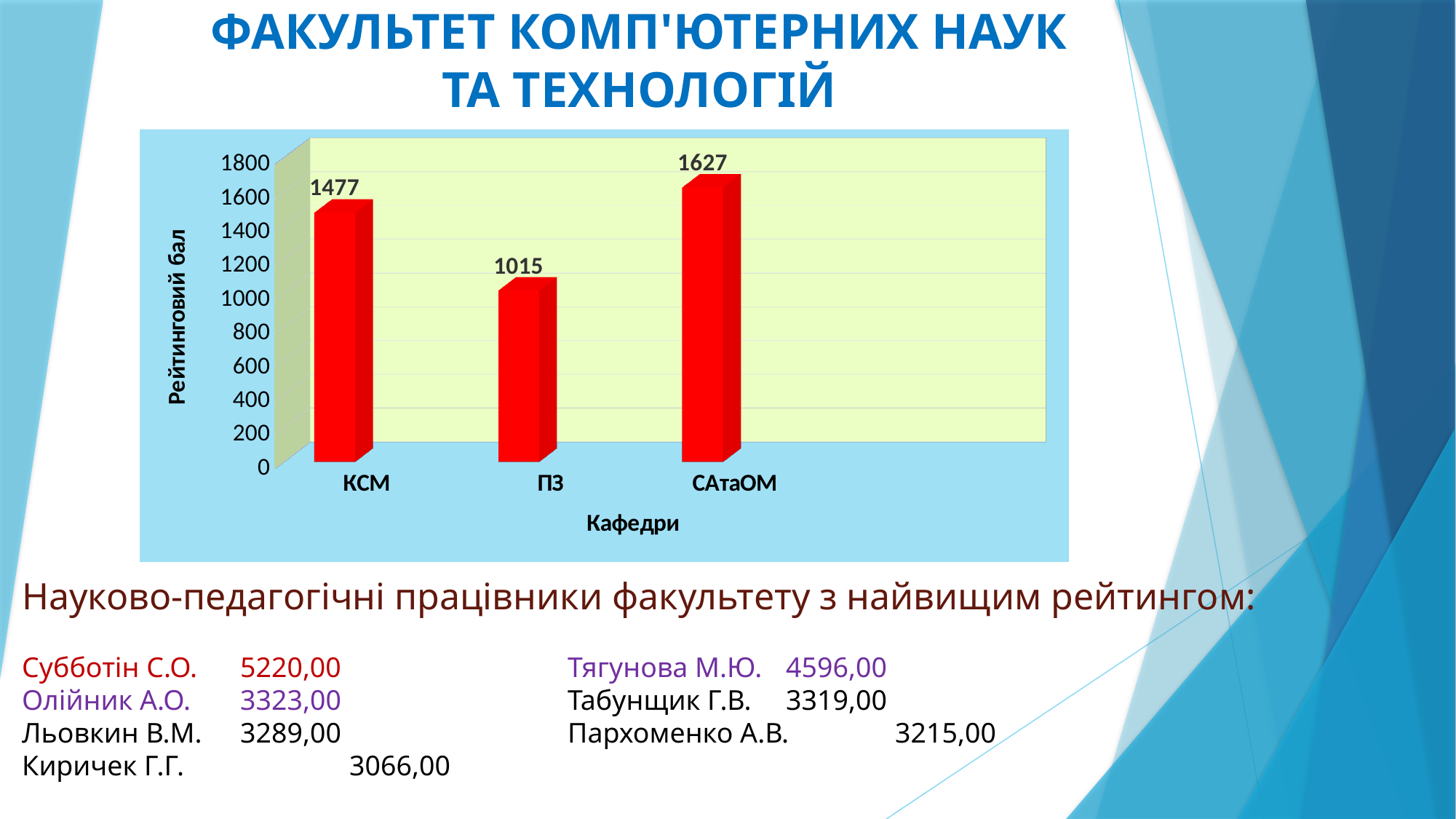
How many departments are shown on the chart? 3 Is the value for ПЗ greater or less than 1200? less What is the difference between the rating scores of САтаОМ and КСМ? 150 Which department has the lowest rating score? ПЗ Which has a higher rating score, КСМ or ПЗ? КСМ What is the label of the vertical axis of the chart? Рейтинговий бал What is the rating score (Рейтинговий бал) for КСМ? 1477 What is the rating score for САтаОМ? 1627 What kind of chart is shown on the slide? bar chart Which department (кафедра) has the highest rating score? САтаОМ What is the rating score for ПЗ? 1015 What is the difference between the rating scores of КСМ and ПЗ? 462